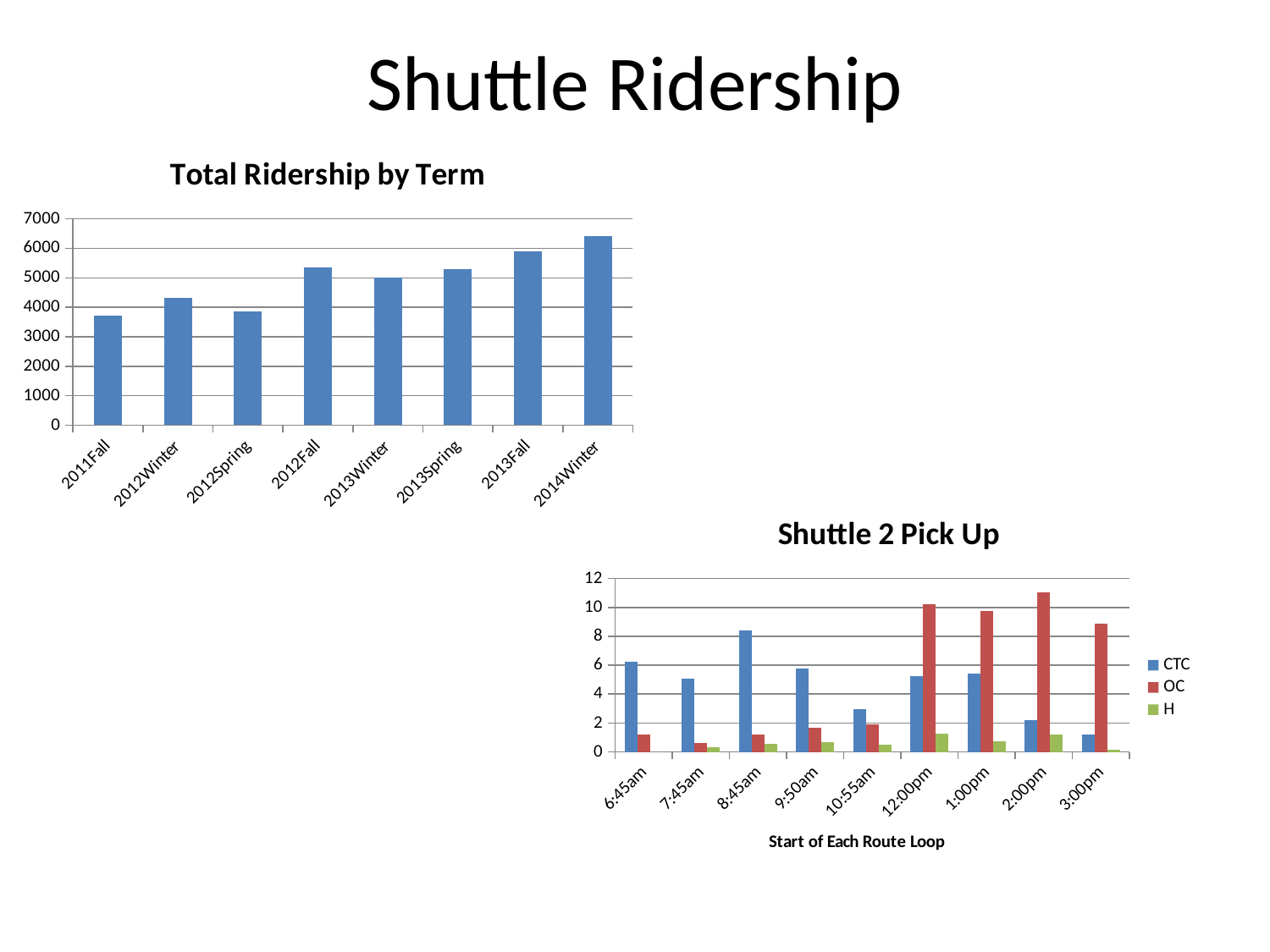
In the 'Total Ridership by Term' chart, which term has the highest ridership? 2014Winter In the 'Total Ridership by Term' chart, is the value for 2011Fall greater or less than 4000? less In the 'Total Ridership by Term' chart, is the value for 2014Winter greater or less than 6000? greater In the 'Total Ridership by Term' chart, which is larger, the value for 2013Fall or 2013Winter? 2013Fall In the 'Shuttle 2 Pick Up' chart, at which time is the OC value highest? 2:00pm In the 'Shuttle 2 Pick Up' chart, at which time is the CTC value highest? 8:45am How many terms are shown in the 'Total Ridership by Term' chart? 8 What kind of chart is 'Total Ridership by Term'? bar chart In the 'Shuttle 2 Pick Up' chart, which is larger at 12:00pm, CTC or OC? OC What is the x-axis title of the 'Shuttle 2 Pick Up' chart? Start of Each Route Loop In the 'Shuttle 2 Pick Up' chart, is the OC value at 2:00pm greater or less than 10? greater In the 'Shuttle 2 Pick Up' chart, how many series does the legend list? 3